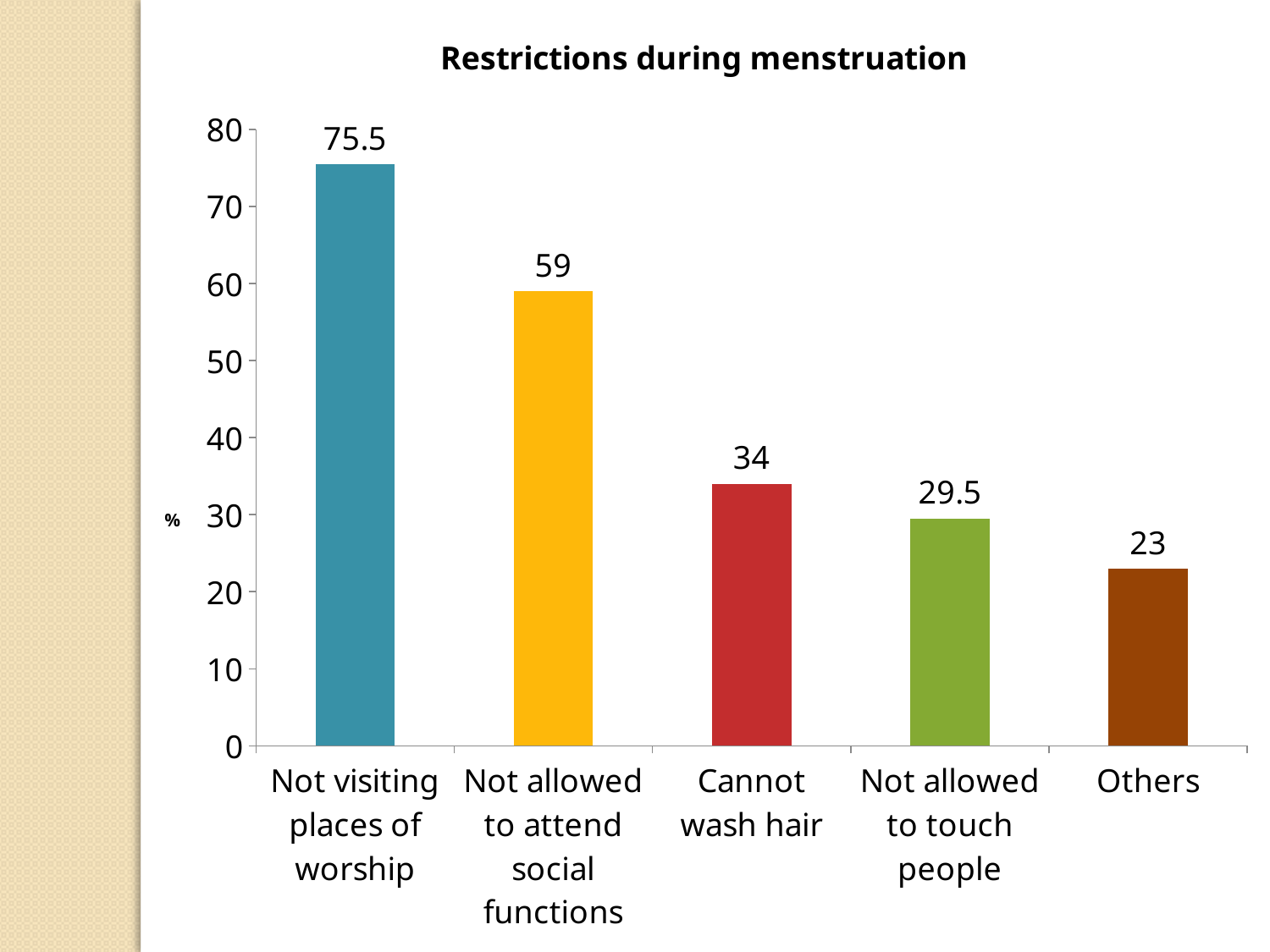
What is the value for 'Not visiting places of worship'? 75.5 Which category has the highest value? Not visiting places of worship What is the difference between 'Not visiting places of worship' and 'Not allowed to attend social functions'? 16.5 What is the value for 'Cannot wash hair'? 34 What kind of chart is shown on the slide? bar chart Which category has the lowest value? Others What is the title of the chart? Restrictions during menstruation Is the value for 'Not allowed to touch people' greater or less than 30? less What is the difference between 'Cannot wash hair' and 'Not allowed to touch people'? 4.5 What is the value for 'Others'? 23 How many categories are shown in the chart? 5 Which is larger, 'Not allowed to attend social functions' or 'Cannot wash hair'? Not allowed to attend social functions